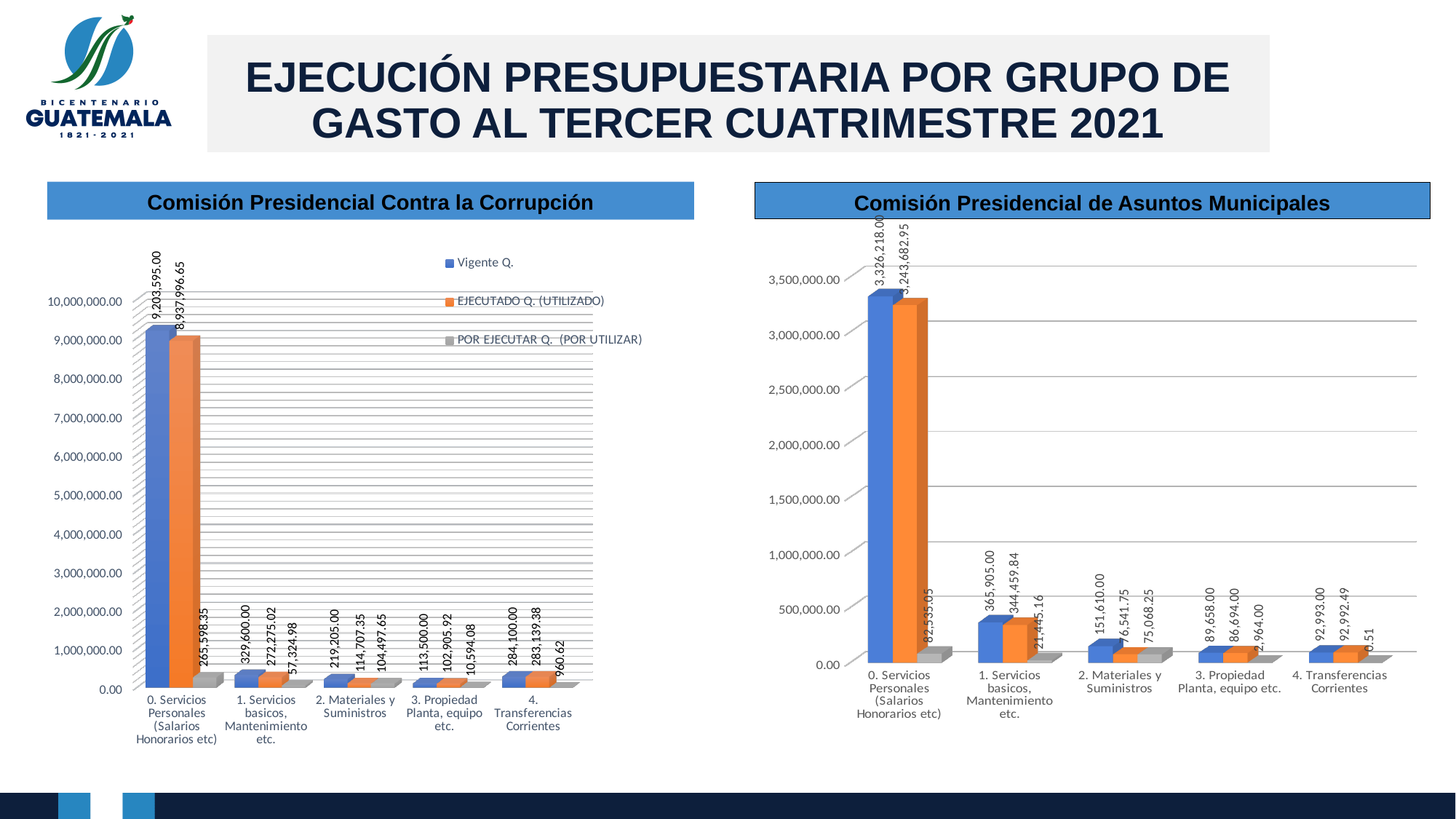
How many series does the legend of the chart titled "Comisión Presidencial Contra la Corrupción" list? 3 In the chart titled "Comisión Presidencial Contra la Corrupción", which category has the lowest Vigente Q. value? 3. Propiedad Planta, equipo etc. In the chart titled "Comisión Presidencial de Asuntos Municipales", is the blue bar for 1. Servicios basicos, Mantenimiento etc. larger or smaller than the blue bar for 2. Materiales y Suministros? Larger In the chart titled "Comisión Presidencial Contra la Corrupción", what is the Vigente Q. value for 0. Servicios Personales (Salarios Honorarios etc)? 9,203,595.00 In the chart titled "Comisión Presidencial de Asuntos Municipales", what is the value of the gray bar for 4. Transferencias Corrientes? 0.51 In the chart titled "Comisión Presidencial Contra la Corrupción", what is the EJECUTADO Q. (UTILIZADO) value for 2. Materiales y Suministros? 114,707.35 In the chart titled "Comisión Presidencial Contra la Corrupción", what is the POR EJECUTAR Q. (POR UTILIZAR) value for 4. Transferencias Corrientes? 960.62 How many categories are shown on the x axis of the chart titled "Comisión Presidencial de Asuntos Municipales"? 5 What kind of chart is the chart titled "Comisión Presidencial de Asuntos Municipales"? Bar chart In the chart titled "Comisión Presidencial Contra la Corrupción", what is the difference between the Vigente Q. and EJECUTADO Q. (UTILIZADO) values for 1. Servicios basicos, Mantenimiento etc.? 57,324.98 In the chart titled "Comisión Presidencial de Asuntos Municipales", what is the value of the blue bar for 0. Servicios Personales (Salarios Honorarios etc)? 3,326,218.00 In the chart titled "Comisión Presidencial de Asuntos Municipales", what is the value of the orange bar for 2. Materiales y Suministros? 76,541.75